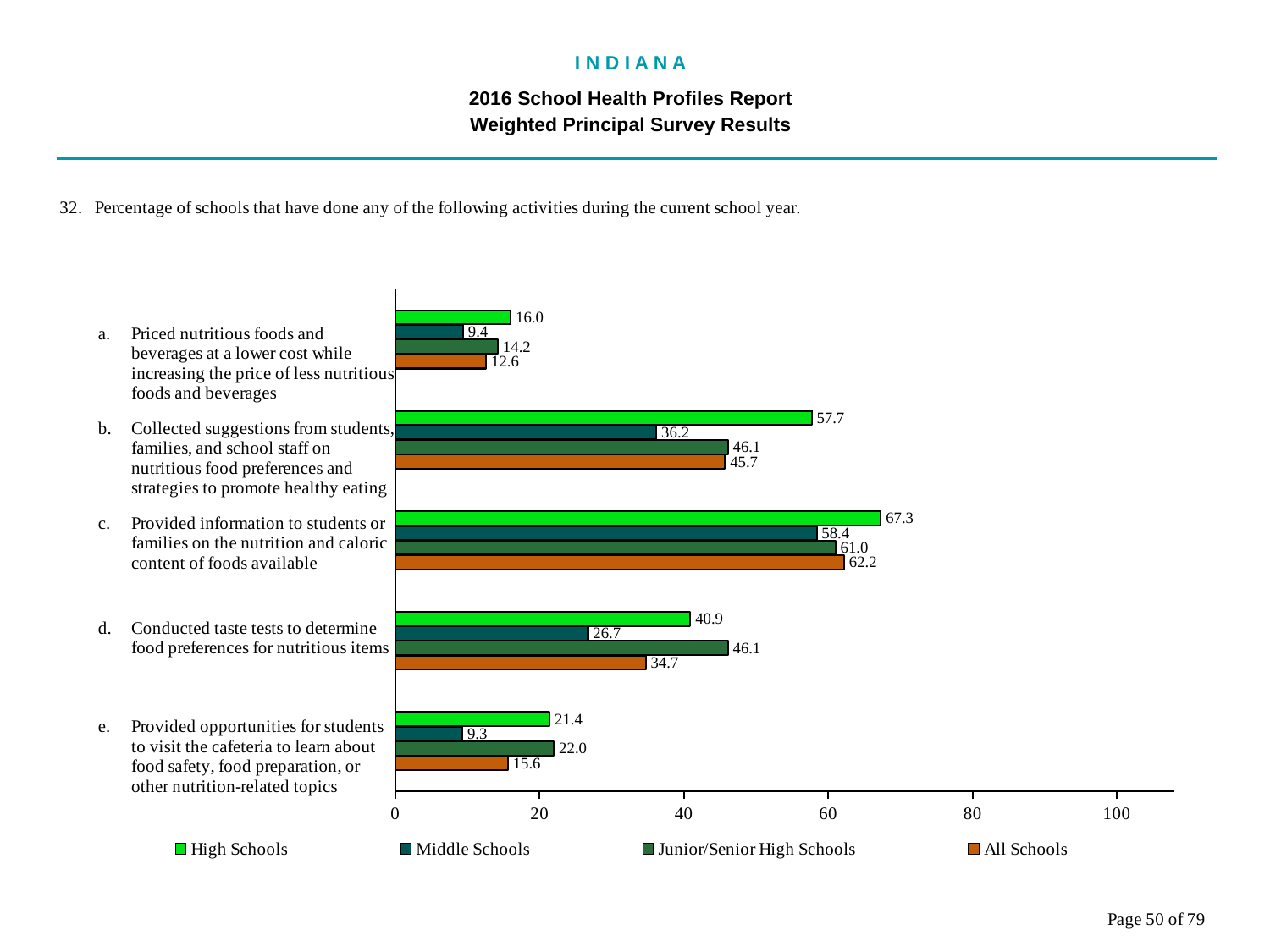
What is the value for Middle Schools for activity a, pricing nutritious foods and beverages at a lower cost? 9.4 Which activity has the highest value for High Schools? c. Provided information to students or families on the nutrition and caloric content of foods available What kind of chart is shown on the slide? Bar chart What is the All Schools value for activity d, conducting taste tests to determine food preferences for nutritious items? 34.7 What is the value for High Schools for activity c, providing information to students or families on the nutrition and caloric content of foods available? 67.3 Which series is shown in orange in the legend? All Schools What is the value for Junior/Senior High Schools for activity e, providing opportunities for students to visit the cafeteria? 22.0 What is the difference between the High Schools and Middle Schools values for activity b, collecting suggestions on nutritious food preferences? 21.5 Which activity has the lowest value for Middle Schools? e. Provided opportunities for students to visit the cafeteria to learn about food safety, food preparation, or other nutrition-related topics How many series does the legend list? 4 For activity d, conducting taste tests, which is larger: the High Schools value or the Junior/Senior High Schools value? Junior/Senior High Schools How many activities (categories) are shown on the chart? 5